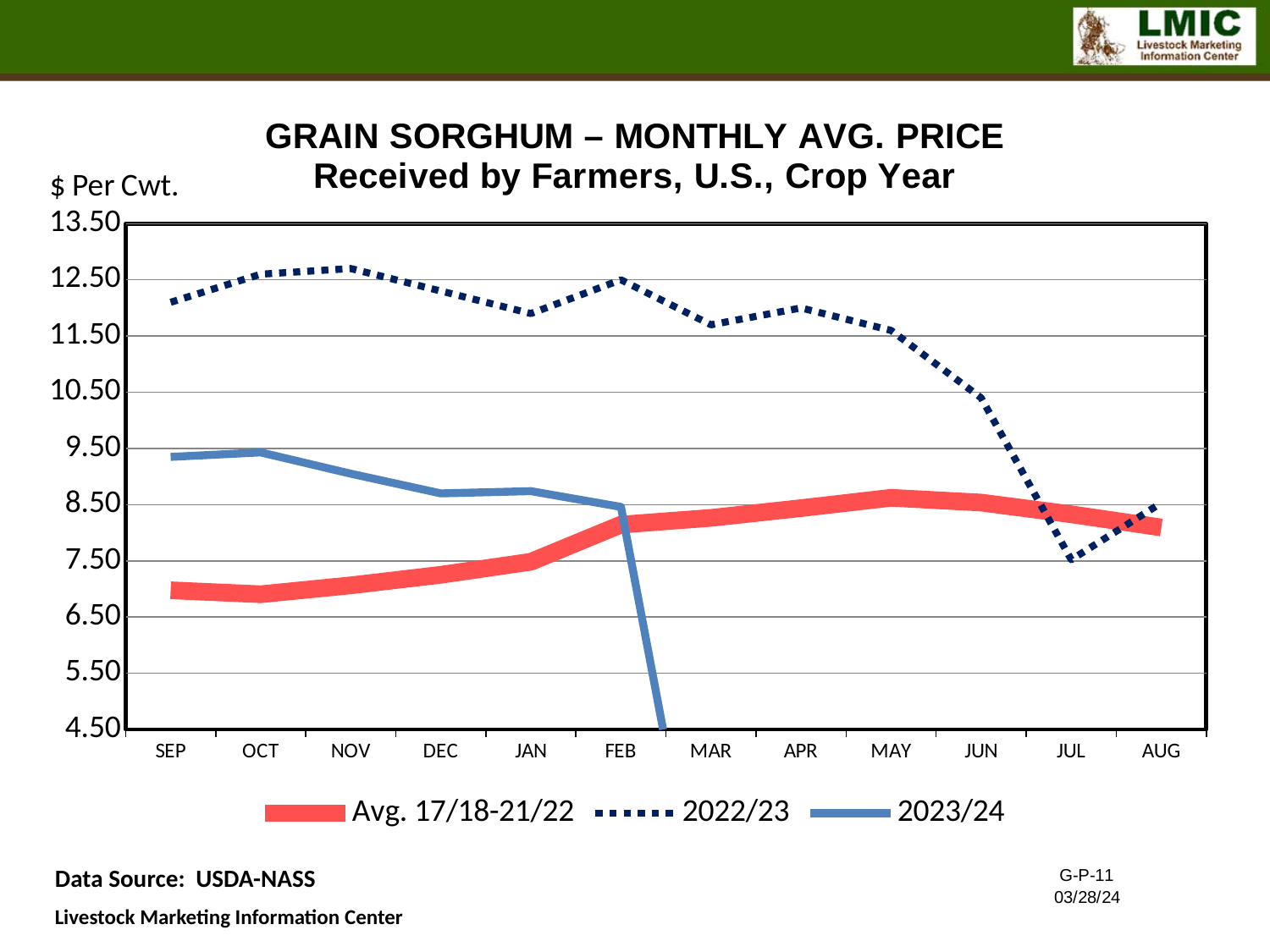
Is the value for 2022/23 in SEP greater or less than 12.50? less In which month does the 2022/23 series reach its lowest value? JUL How many series does the legend list? 3 What unit is shown on the y axis? $ Per Cwt. What kind of chart is shown on the slide? line chart In SEP, which series has the larger value, 2022/23 or 2023/24? 2022/23 Is the value for 2022/23 in NOV greater or less than 12.50? greater Is the value for Avg. 17/18-21/22 in SEP greater or less than 6.50? greater How many months are shown along the x axis? 12 In which month does the 2022/23 series reach its highest value? NOV Does the 2023/24 series rise or fall from SEP to FEB? fall